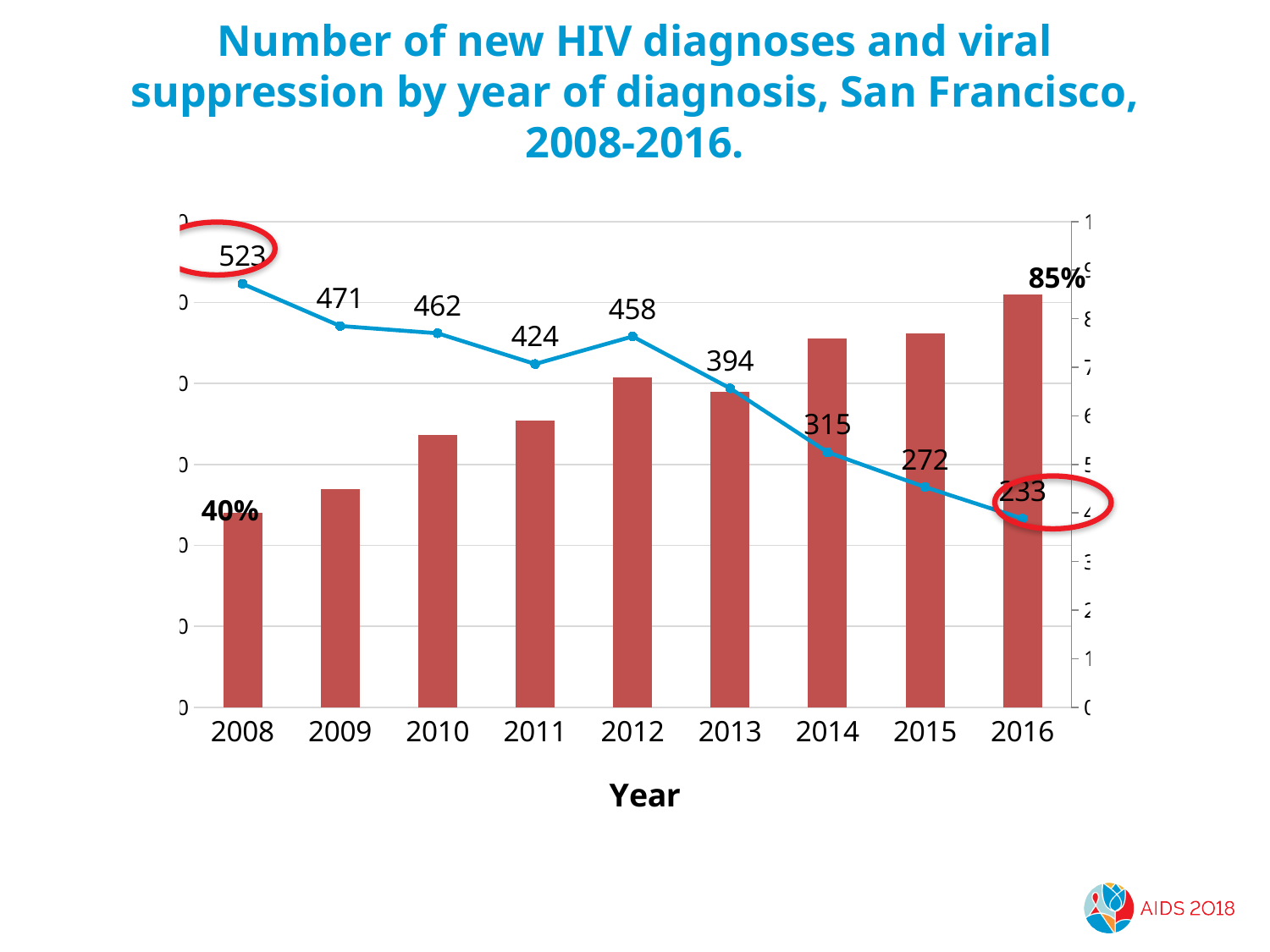
How many new HIV diagnoses were there in 2012? 458 How many years are shown on the x axis? 9 What is the viral suppression percentage shown for 2008? 40% What is the title of the x axis? Year How many new HIV diagnoses were there in 2008? 523 What is the viral suppression percentage shown for 2016? 85% Does the number of new HIV diagnoses generally rise or fall from 2008 to 2016? fall How many new HIV diagnoses were there in 2016? 233 Which year had the highest number of new HIV diagnoses? 2008 Which year had the lowest number of new HIV diagnoses? 2016 What is the difference in the number of new HIV diagnoses between 2008 and 2016? 290 Which year had more new HIV diagnoses, 2011 or 2012? 2012